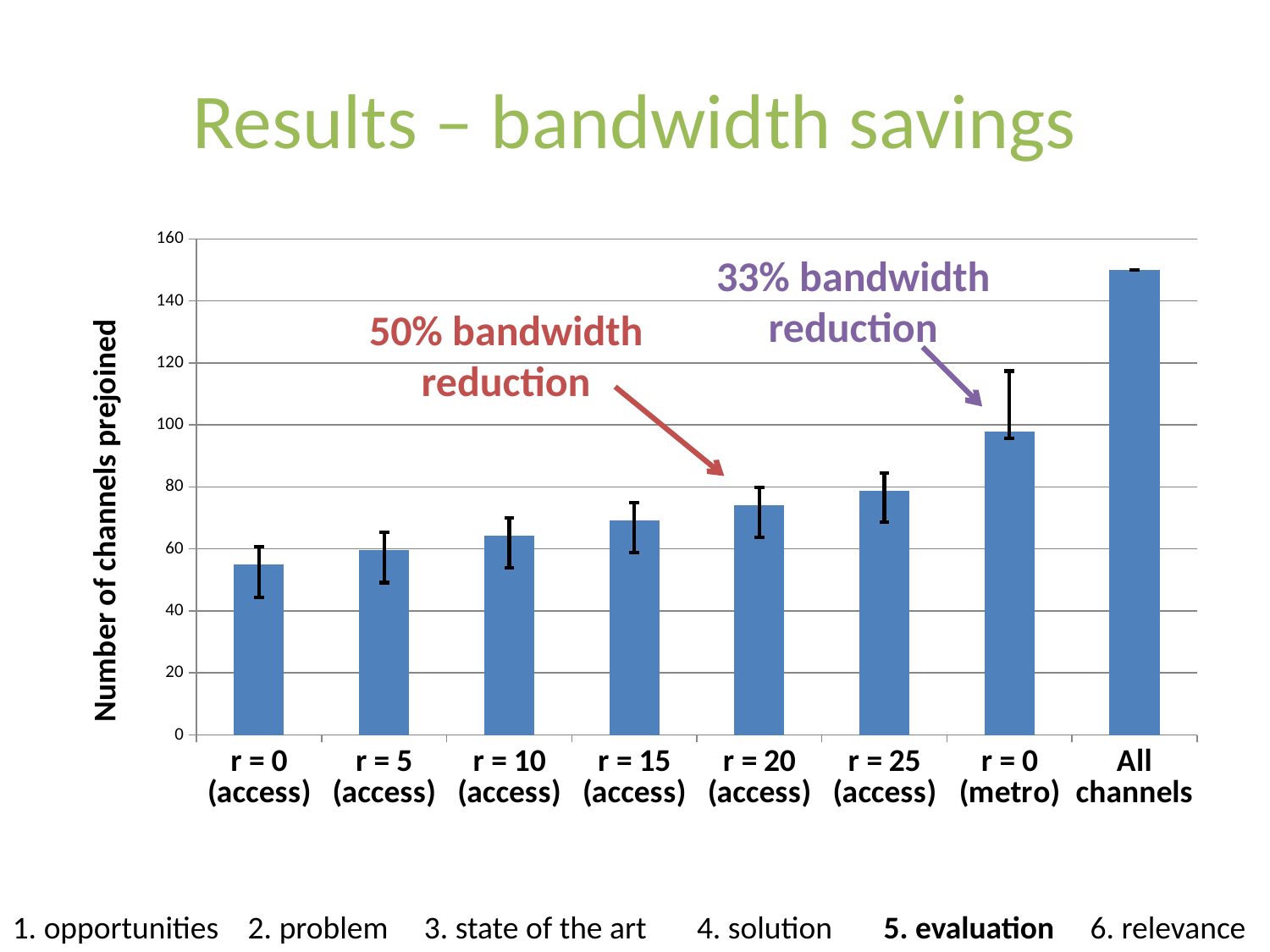
What is the label of the vertical axis of the chart? Number of channels prejoined Which is larger, the value for r = 0 (metro) or the value for r = 25 (access)? r = 0 (metro) Which category has the lowest number of channels prejoined? r = 0 (access) How many categories are shown on the x axis of the chart? 8 Is the value for r = 0 (access) greater or less than 60? less Is the value for r = 15 (access) greater or less than 80? less What type of chart is shown on the slide? bar chart Is the value for r = 20 (access) greater or less than 60? greater Which category has the highest number of channels prejoined? All channels Do the values rise or fall across the access categories from r = 0 to r = 25? rise